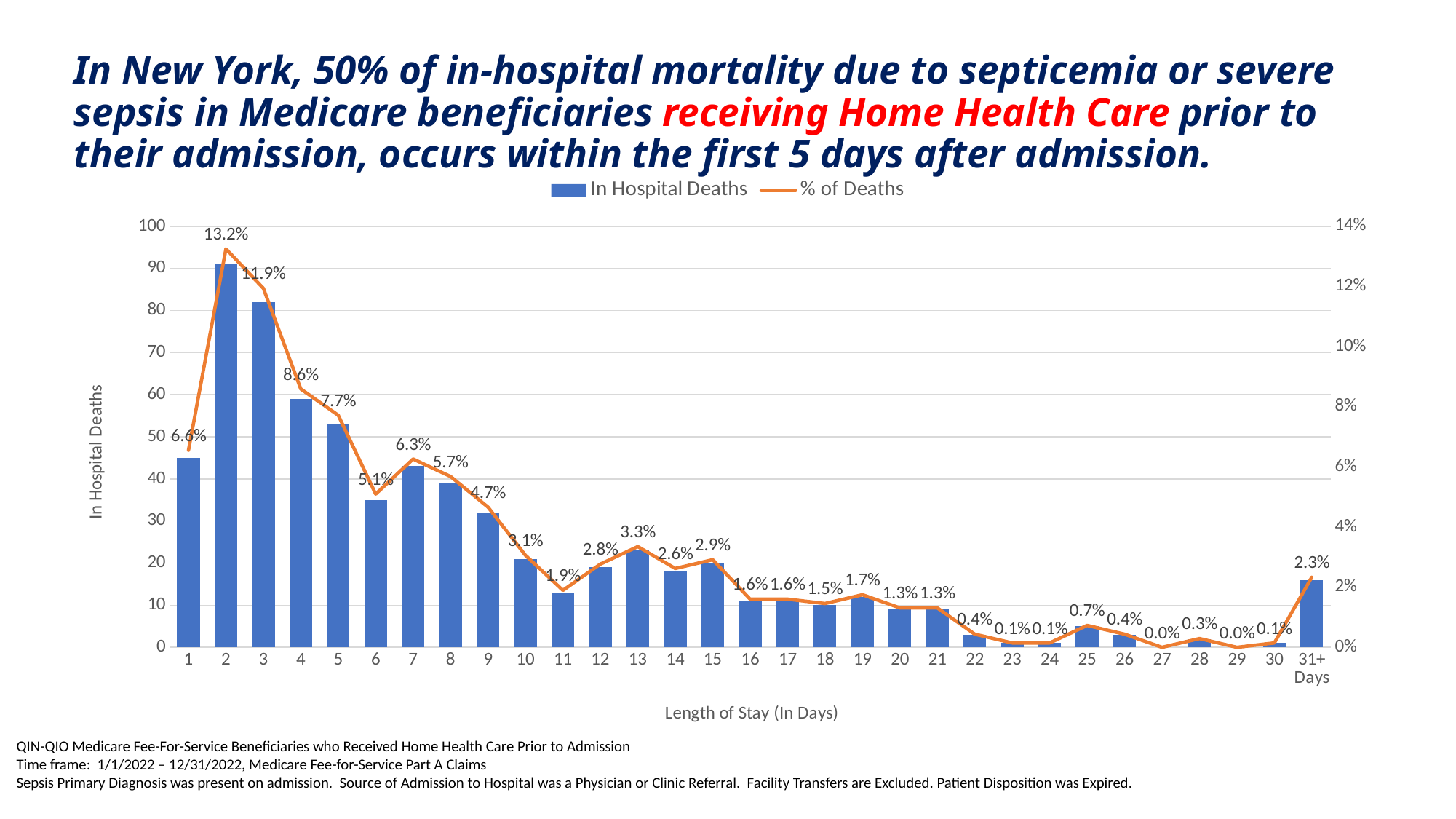
What is the % of Deaths value for the 31+ Days category? 2.3% Is the In Hospital Deaths value for day 1 greater or less than 50? less Which is larger, the % of Deaths at day 13 or at day 14? Day 13 Is the In Hospital Deaths value for day 2 greater or less than 80? greater Which length of stay has the highest % of Deaths? 2 What is the % of Deaths value for a length of stay of 2 days? 13.2% Is the In Hospital Deaths value for day 6 greater or less than 40? less What is the label of the x axis? Length of Stay (In Days) How many length-of-stay categories are shown on the x axis? 31 What is the % of Deaths value for a length of stay of 7 days? 6.3% What is the difference between the % of Deaths at day 2 and at day 3? 1.3% How many series does the legend list? 2